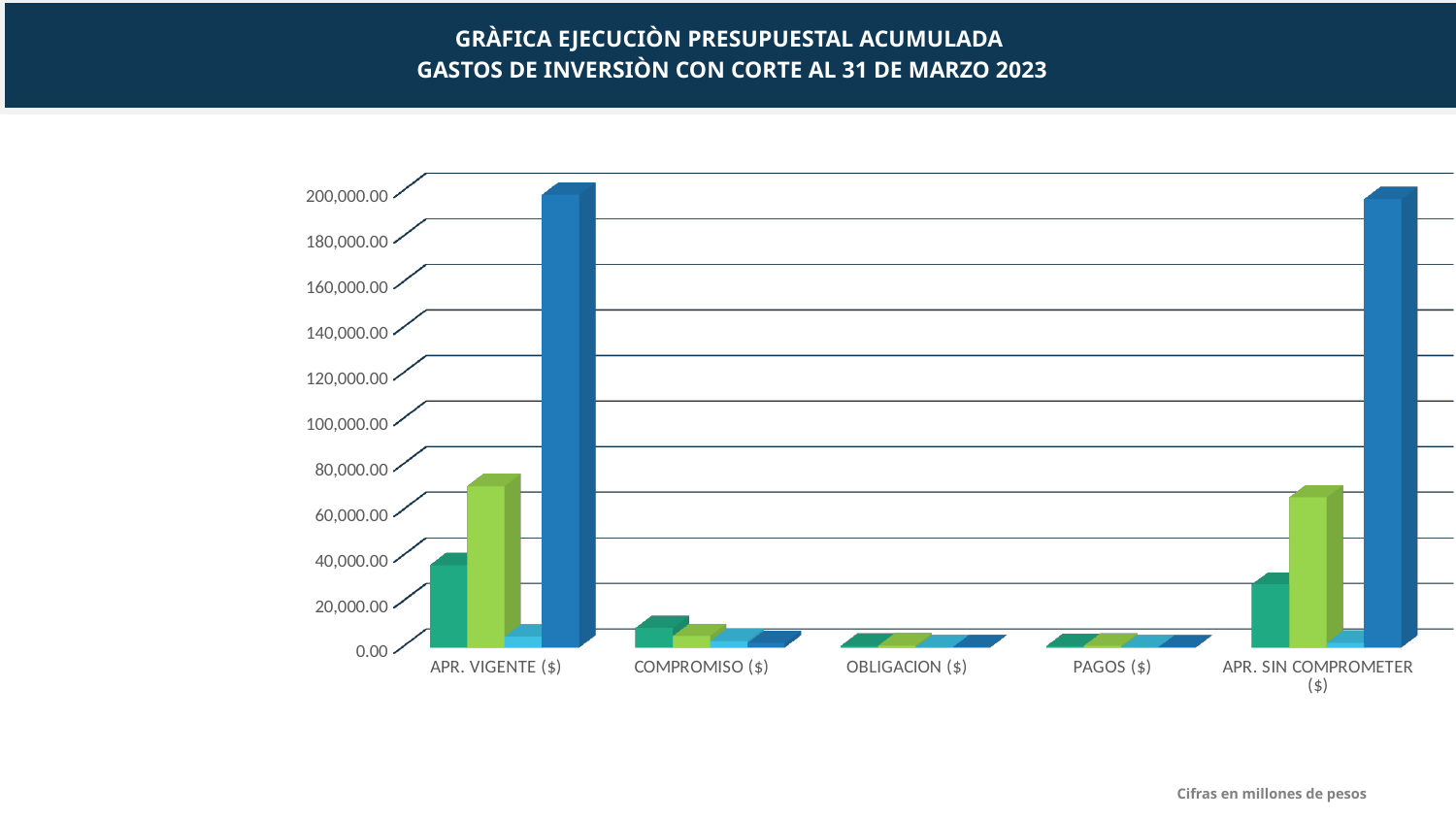
What is the highest value shown on the vertical axis of the chart? 200,000.00 Is the value of the light green bar for APR. VIGENTE ($) greater or less than 80,000.00? less According to the note on the slide, in what units are the figures in the chart expressed? Millones de pesos What kind of chart is shown on the slide? Bar chart Is the value of the teal bar for APR. VIGENTE ($) greater or less than 20,000.00? greater How many bars are plotted for each category in the chart? 4 How many categories are shown on the x axis of the chart? 5 Is the value of the teal bar for COMPROMISO ($) greater or less than 20,000.00? less Which is larger: the light green bar for APR. VIGENTE ($) or the light green bar for COMPROMISO ($)? APR. VIGENTE ($)